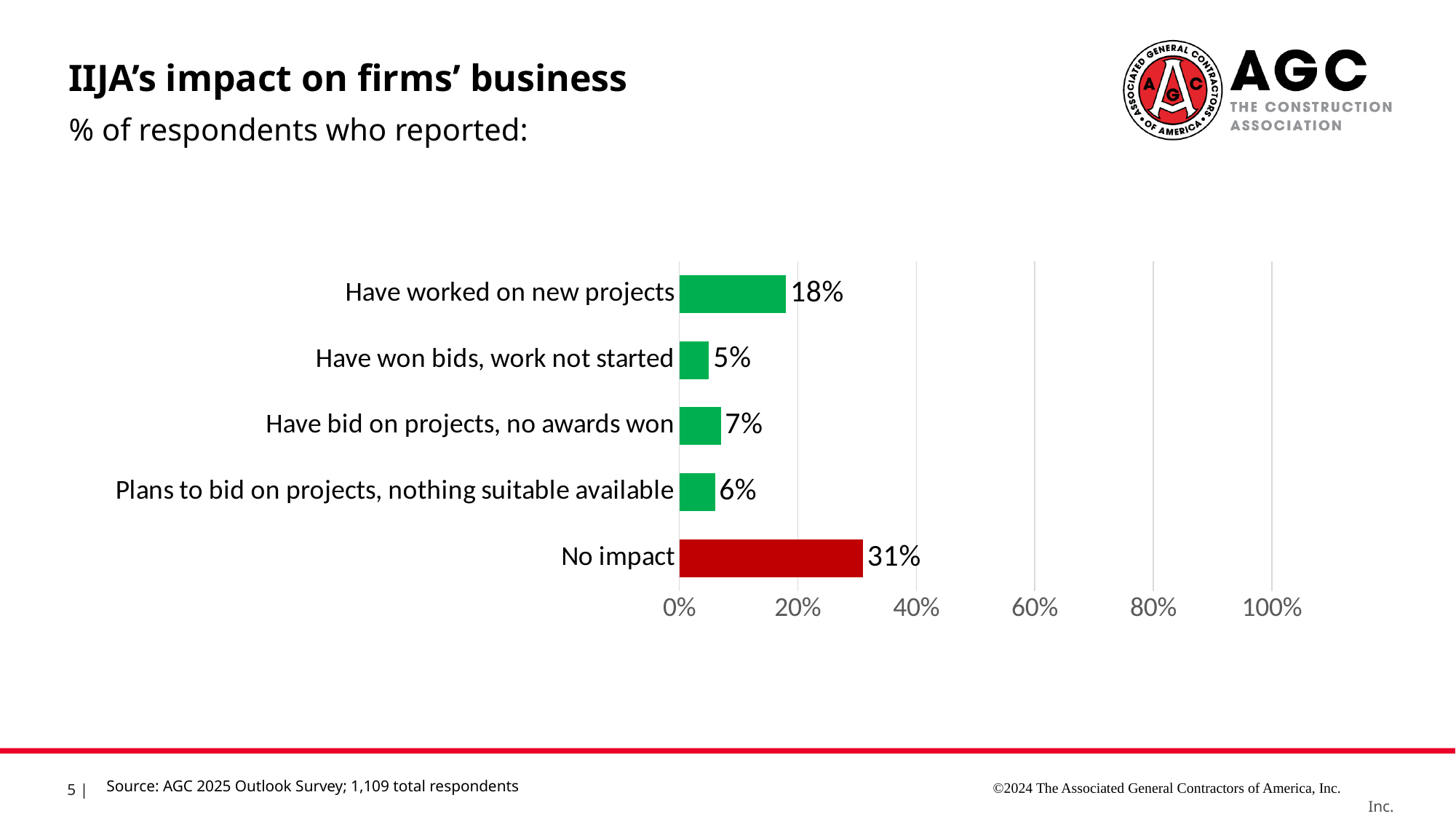
Is the value for 'No impact' greater or less than 20%? greater Which is larger: 'Have bid on projects, no awards won' or 'Plans to bid on projects, nothing suitable available'? Have bid on projects, no awards won How many categories are shown in the chart? 5 What percentage of respondents reported no impact? 31% What percentage of respondents reported plans to bid on projects but nothing suitable available? 6% What percentage of respondents reported they have won bids but work has not started? 5% Which bar is coloured red rather than green? No impact Which category has the highest percentage of respondents? No impact What type of chart is shown on the slide? Bar chart What percentage of respondents reported they have worked on new projects? 18% Which category has the lowest percentage of respondents? Have won bids, work not started What is the difference in percentage points between 'No impact' and 'Have worked on new projects'? 13